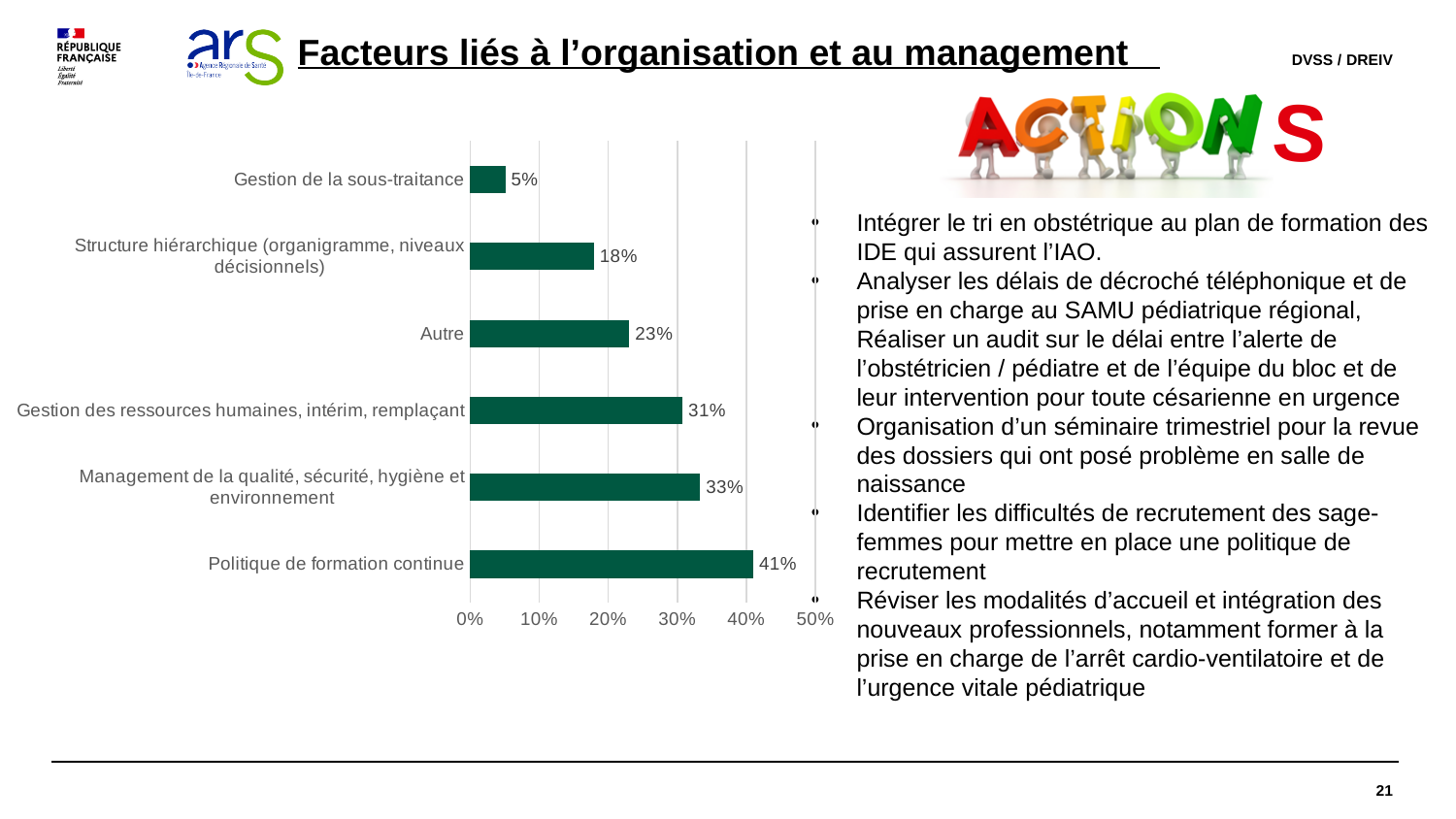
What is the value for Autre? 23% What kind of chart is shown on the slide? bar chart Which is larger: Autre or Structure hiérarchique (organigramme, niveaux décisionnels)? Autre What is the maximum value shown on the horizontal axis? 50% What is the difference between Politique de formation continue and Management de la qualité, sécurité, hygiène et environnement? 8% Is the value for Gestion des ressources humaines, intérim, remplaçant greater or less than 20%? greater Which category has the lowest value? Gestion de la sous-traitance What is the value for Gestion de la sous-traitance? 5% How many categories are shown in the chart? 6 What is the value for Gestion des ressources humaines, intérim, remplaçant? 31% Which category has the highest value? Politique de formation continue What is the value for Politique de formation continue? 41%